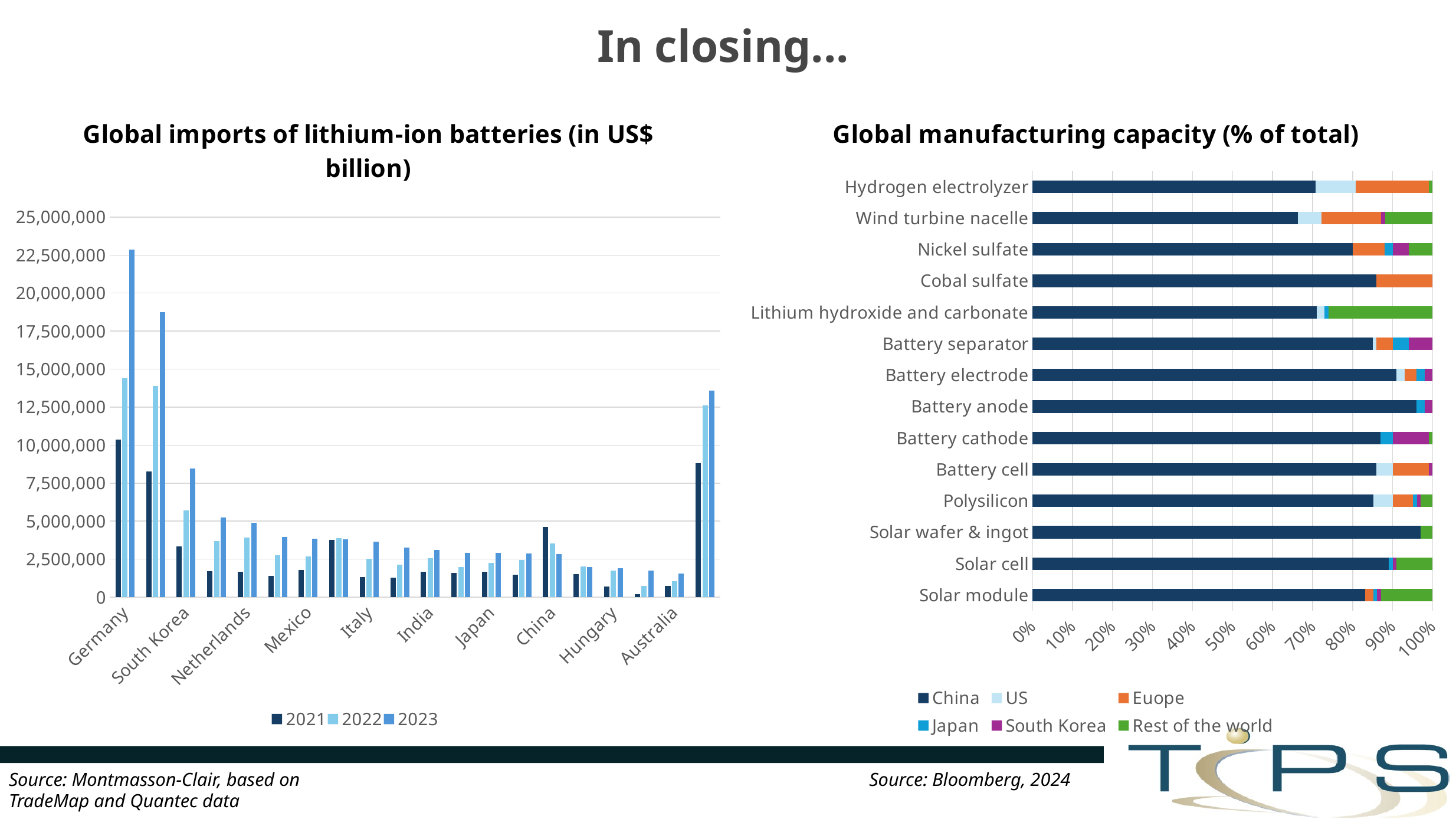
On the left chart (Global imports of lithium-ion batteries), how many series does the legend list? 3 On the right chart (Global manufacturing capacity), what kind of chart is it? stacked bar chart On the right chart (Global manufacturing capacity), is China's share for Solar wafer & ingot greater or less than 90%? greater On the left chart (Global imports of lithium-ion batteries), which is larger for 2023: Germany or South Korea? Germany On the left chart (Global imports of lithium-ion batteries), do the values for China rise or fall from 2021 to 2023? fall On the left chart (Global imports of lithium-ion batteries), which year's bar is the highest for Germany? 2023 On the right chart (Global manufacturing capacity), how many series does the legend list? 6 On the left chart (Global imports of lithium-ion batteries), is the 2021 value for Netherlands greater or less than 2,500,000? less On the left chart (Global imports of lithium-ion batteries), is the 2023 value for Germany greater or less than 20,000,000? greater On the right chart (Global manufacturing capacity), how many product categories are shown? 14 On the right chart (Global manufacturing capacity), which category has the largest Rest of the world share? Lithium hydroxide and carbonate